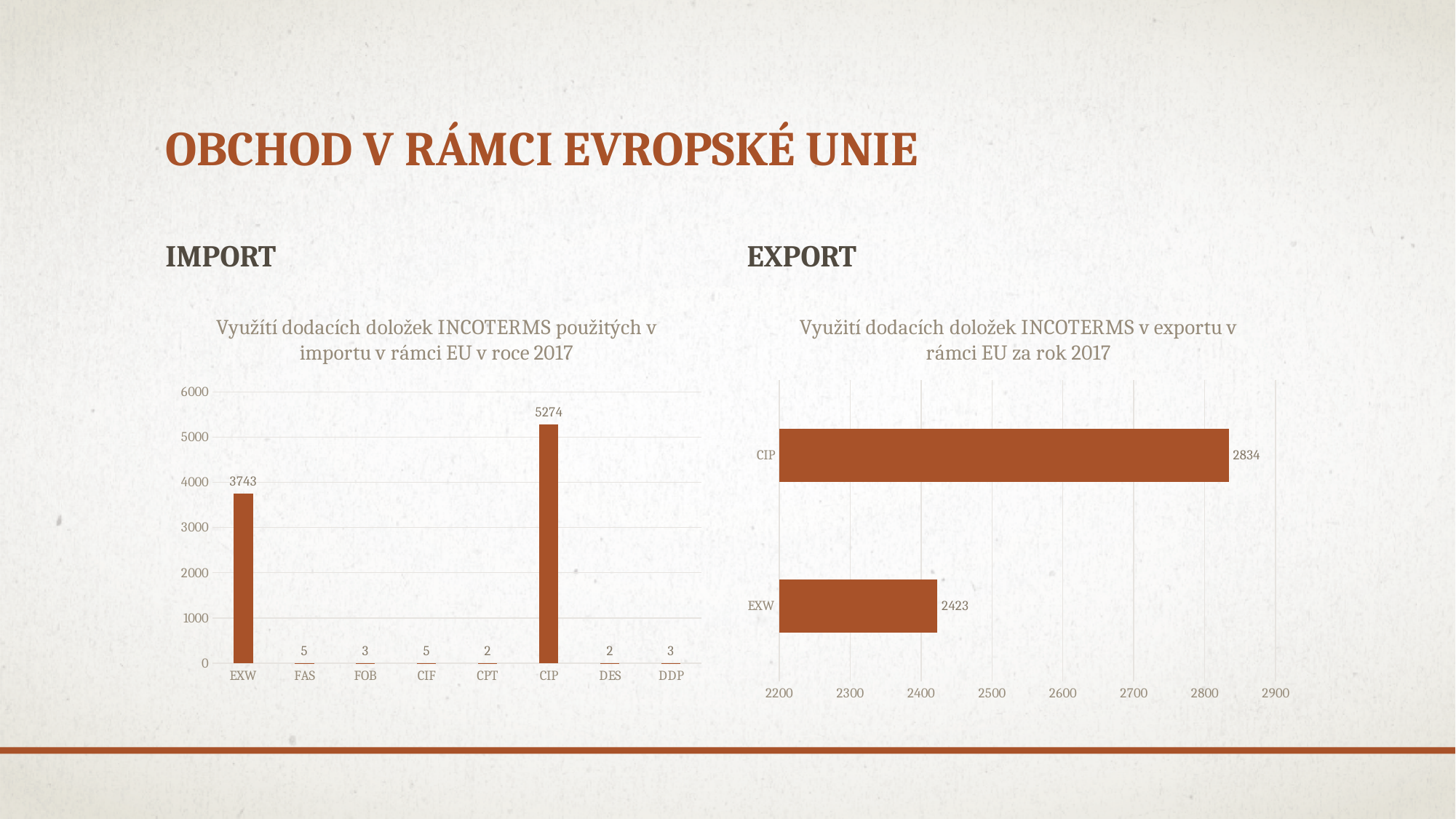
In the import chart, what is the value for CIP? 5274 What kind of chart is the export chart? Bar chart In the import chart, how many categories are shown on the x axis? 8 In the import chart, what is the difference between the values for CIP and EXW? 1531 In the import chart, is the value for EXW greater or less than 3000? greater In the import chart, what is the value for CPT? 2 In the export chart, which category has the lowest value? EXW In the export chart, what is the value for CIP? 2834 In the export chart, what is the difference between the values for CIP and EXW? 411 In the import chart, which category has the highest value? CIP In the import chart, what is the value for EXW? 3743 In the export chart, what is the value for EXW? 2423